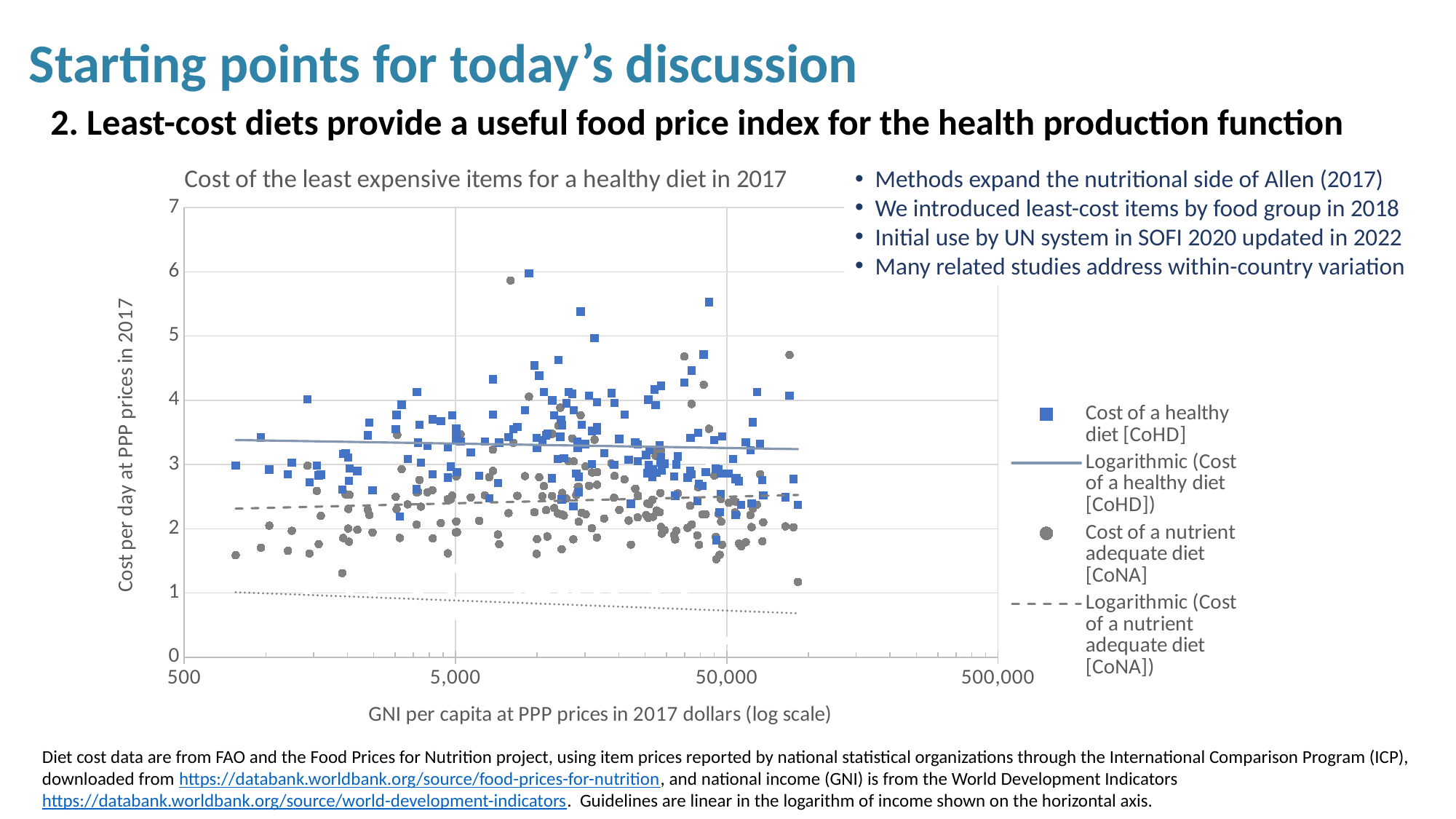
What kind of chart is shown on the slide? Scatter chart Which series generally has higher values: Cost of a healthy diet [CoHD] or Cost of a nutrient adequate diet [CoNA]? Cost of a healthy diet [CoHD] Is the highest Cost of a healthy diet [CoHD] point greater or less than 5? Greater What is the label of the chart's vertical axis? Cost per day at PPP prices in 2017 Is the logarithmic trendline for the Cost of a nutrient adequate diet [CoNA] greater or less than 3? Less Is the logarithmic trendline for the Cost of a healthy diet [CoHD] above or below 3 on the vertical axis? Above What is the title of the chart? Cost of the least expensive items for a healthy diet in 2017 What is the maximum value shown on the chart's vertical axis? 7 Which series is plotted with blue square markers? Cost of a healthy diet [CoHD] How many entries does the chart's legend list? 4 Does the logarithmic trendline for the Cost of a healthy diet [CoHD] rise or fall as GNI per capita increases? Fall